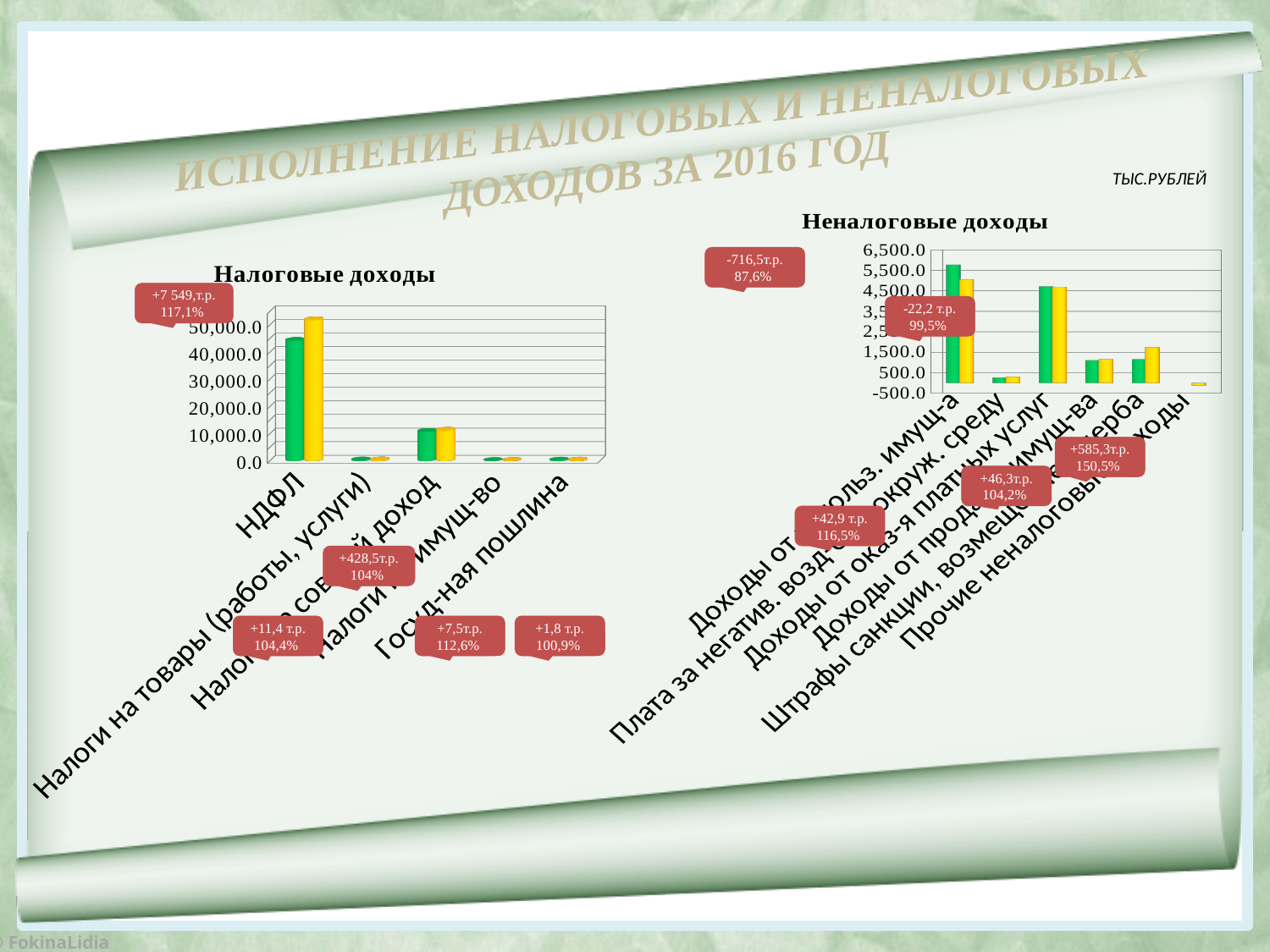
What two colours are used for the bars in the charts? green and yellow How many categories are shown on the x axis of the "Неналоговые доходы" chart? 6 In the "Неналоговые доходы" chart, which is larger: the bars for Доходы от оказ-я платных услуг or for Прочие неналоговые доходы? Доходы от оказ-я платных услуг What kind of chart is the "Налоговые доходы" chart? bar chart In the "Неналоговые доходы" chart, are the bars for Доходы от оказ-я платных услуг greater or less than 3,500.0? greater In the "Налоговые доходы" chart, are the bars for Госуд-ная пошлина greater or less than 10,000.0? less In the "Неналоговые доходы" chart, is the yellow bar for Прочие неналоговые доходы greater or less than 500.0? less How many categories are shown on the x axis of the "Налоговые доходы" chart? 5 In the "Налоговые доходы" chart, which is larger: the bars for НДФЛ or for Госуд-ная пошлина? НДФЛ In the "Налоговые доходы" chart, which category has the highest bars? НДФЛ What unit of measurement is stated on the slide for the charts? ТЫС.РУБЛЕЙ